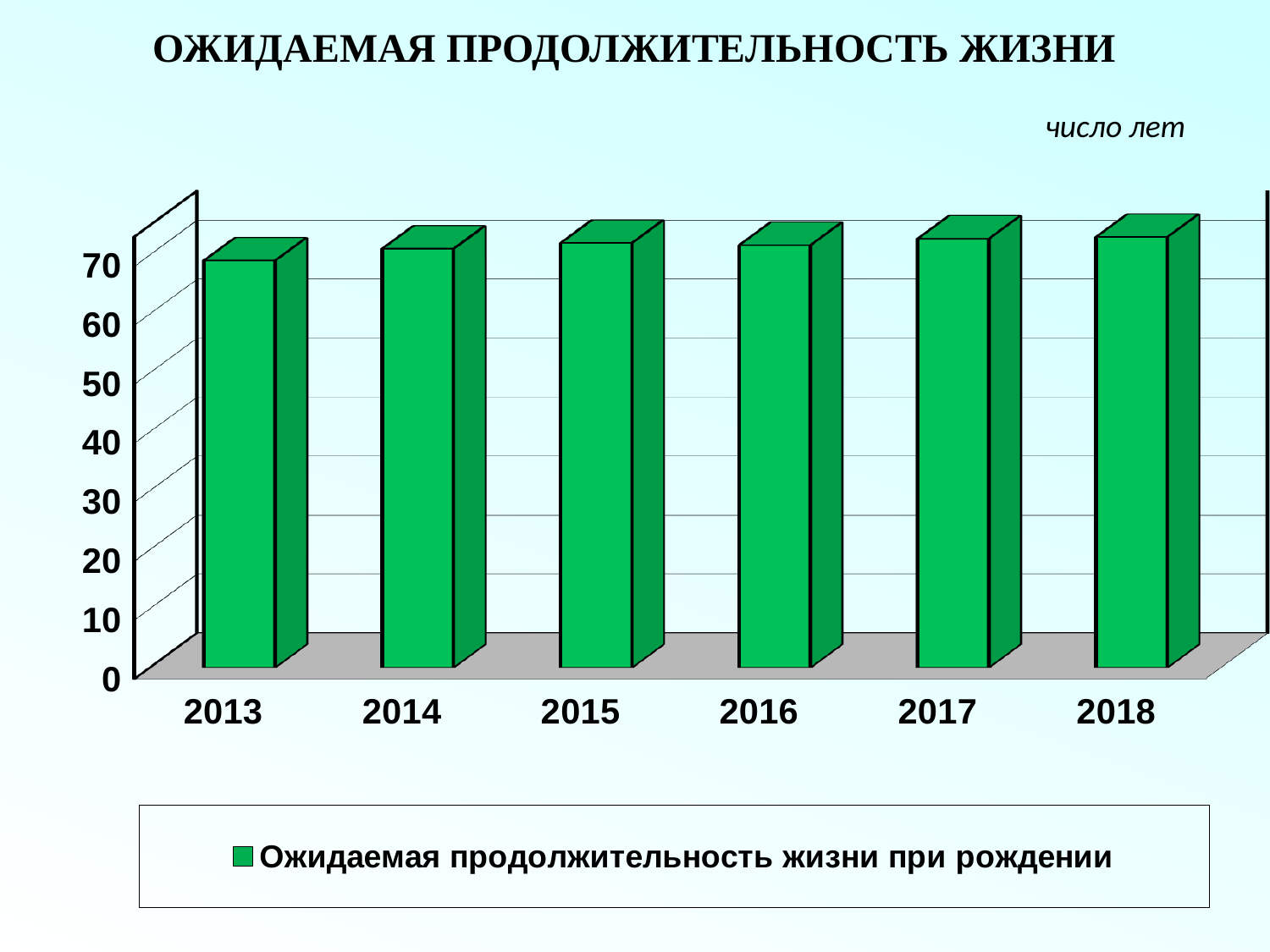
Is the value for 2013 greater or less than 60? greater What kind of chart is shown on the slide? bar chart Is the value for 2015 greater or less than 50? greater What is the title of the chart? ОЖИДАЕМАЯ ПРОДОЛЖИТЕЛЬНОСТЬ ЖИЗНИ How many series does the legend list? 1 What series name is given in the legend? Ожидаемая продолжительность жизни при рождении Which is larger, the value for 2013 or the value for 2016? 2016 Which year has the lowest bar? 2013 Do the values generally rise or fall from 2013 to 2018? rise Is the value for 2018 greater or less than 60? greater Which is larger, the value for 2013 or the value for 2018? 2018 How many years are shown on the x axis of the chart? 6